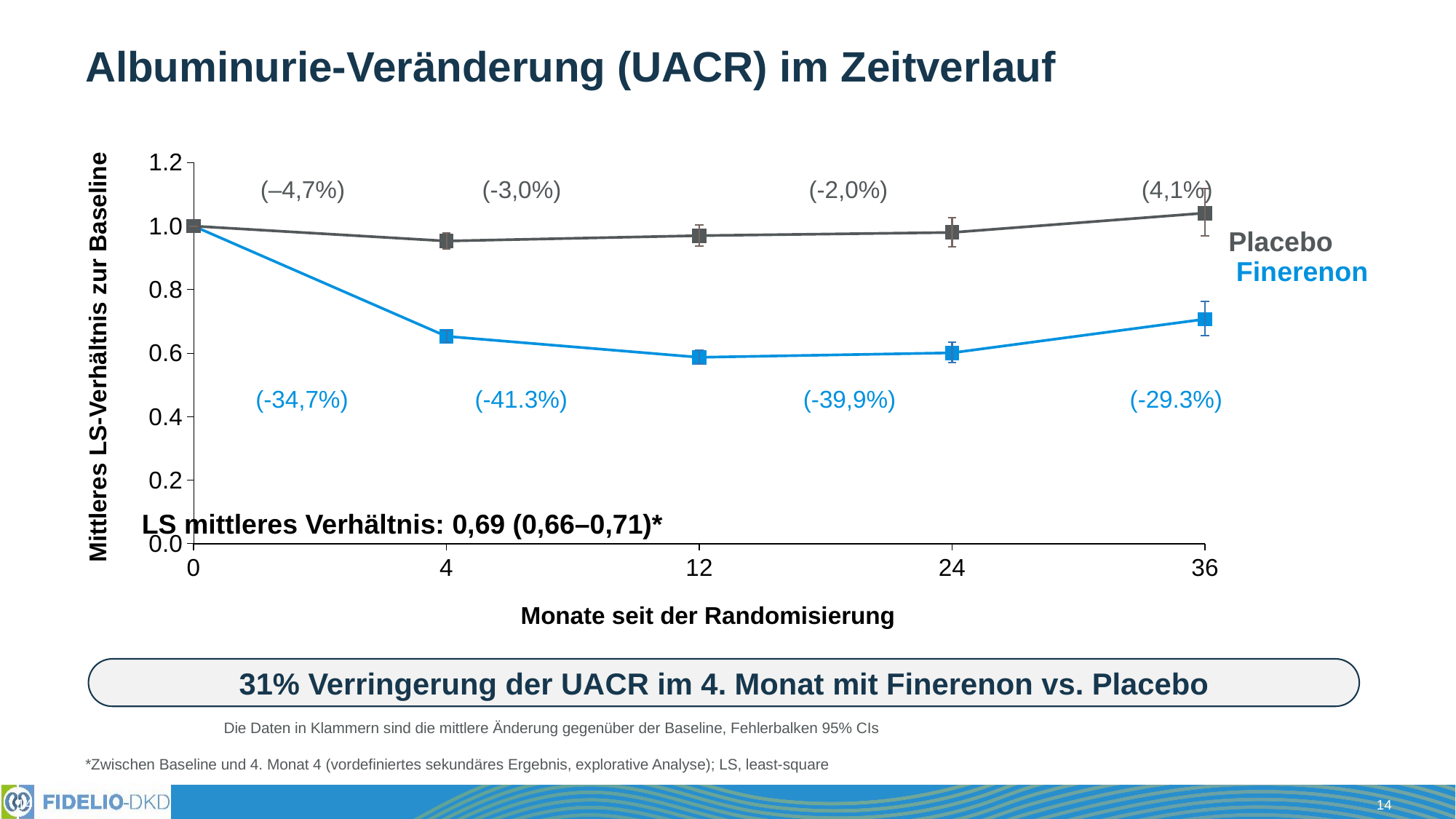
Does the Finerenon line rise or fall between month 0 and month 12? Fall At month 12, which series has the higher value, Placebo or Finerenon? Placebo Is the value for Finerenon at month 4 greater or less than 0.8? less At which month does Finerenon show the largest percentage reduction from baseline according to the labels? 12 How many time points are shown on the x axis of the chart? 5 What percentage change from baseline is shown for Finerenon at month 4? -34,7% How many series are plotted in the chart? 2 What percentage change from baseline is shown for Placebo at month 36? 4,1% What percentage change from baseline is shown for Finerenon at month 12? -41.3% Is the value for Placebo at month 36 greater or less than 1.0? greater What is the mean LS ratio to baseline for both series at month 0? 1.0 What kind of chart is shown on the slide? Line chart